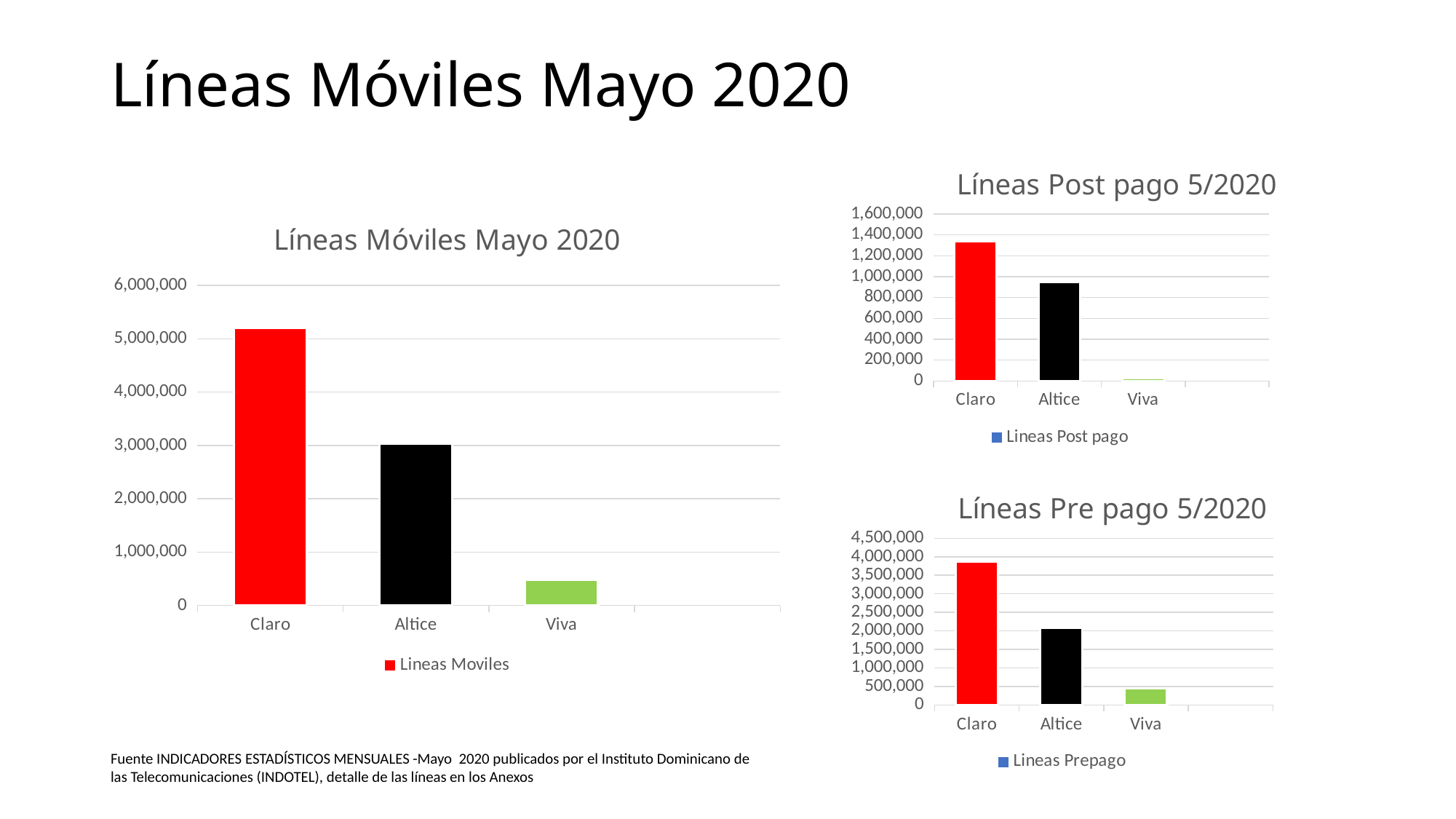
In the chart titled 'Líneas Móviles Mayo 2020', which category has the lowest value? Viva In the chart titled 'Líneas Post pago 5/2020', is the value for Claro greater or less than 1,200,000? greater In the chart titled 'Líneas Móviles Mayo 2020', how many categories are shown on the x axis? 3 In the chart titled 'Líneas Pre pago 5/2020', which is larger, the value for Altice or the value for Viva? Altice In the chart titled 'Líneas Post pago 5/2020', which category has the lowest value? Viva In the chart titled 'Líneas Post pago 5/2020', is the value for Altice greater or less than 1,000,000? less What kind of chart is the chart titled 'Líneas Post pago 5/2020'? bar chart In the chart titled 'Líneas Móviles Mayo 2020', is the value for Claro greater or less than 5,000,000? greater What is the legend entry shown in the chart titled 'Líneas Pre pago 5/2020'? Lineas Prepago In the chart titled 'Líneas Móviles Mayo 2020', which category has the highest value? Claro